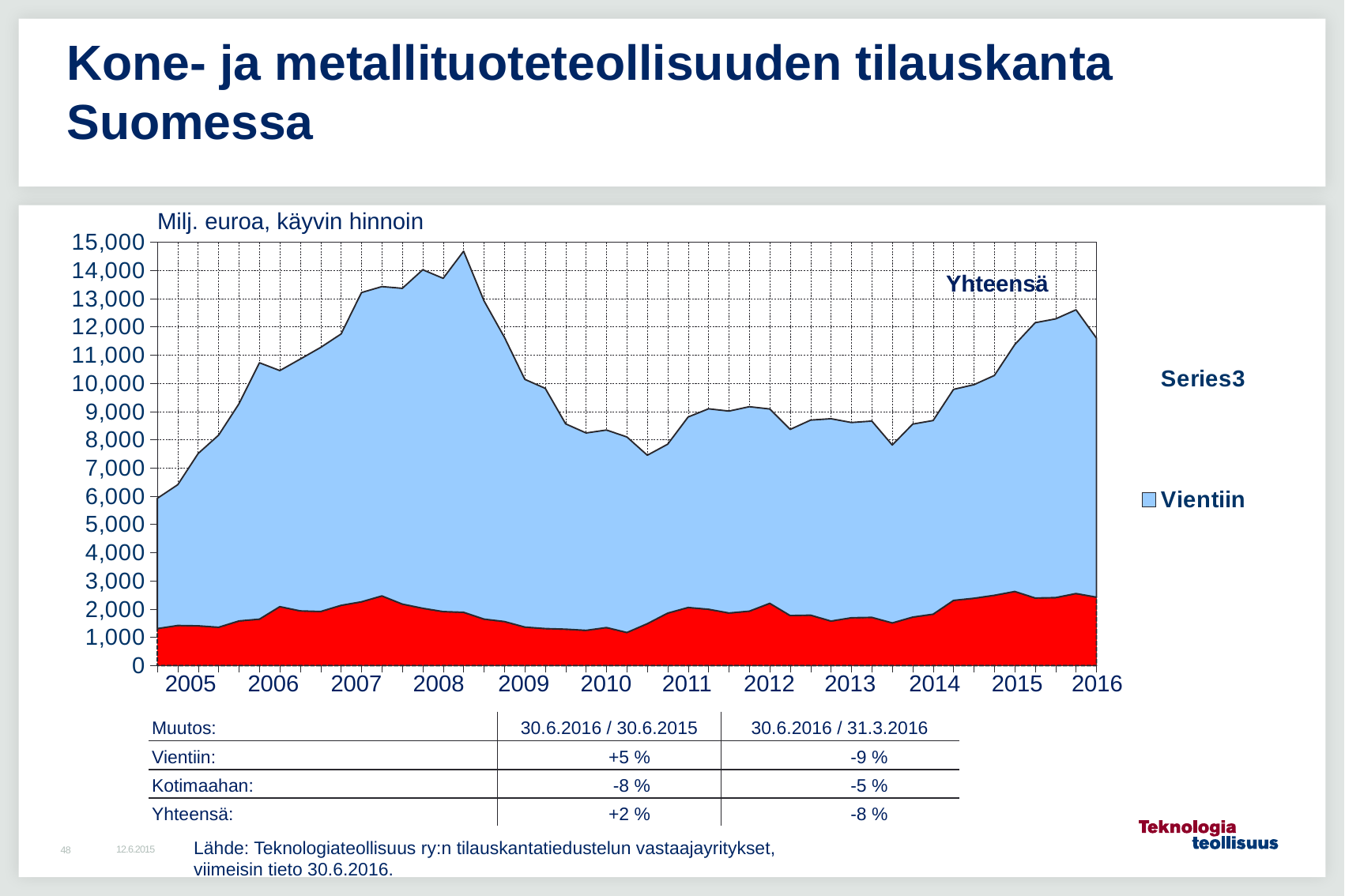
What kind of chart is shown on the slide? area chart Does the total value rise or fall between 2013 and 2015? rise What unit label is shown above the chart's y axis? Milj. euroa, käyvin hinnoin Is the value of the red (bottom) area at its highest point in 2007 greater or less than 3,000? less Is the total value at the end of the series in 2016 greater or less than 11,000? greater How many year labels are shown on the x axis of the chart? 12 Is the total value at the low point in 2010 greater or less than 8,000? less How many entries does the chart legend list? 2 Does the total value rise or fall between the 2008 peak and 2010? fall In which year does the total (Yhteensä) reach its highest peak? 2008 What are the two entries listed in the chart legend? Series3 and Vientiin